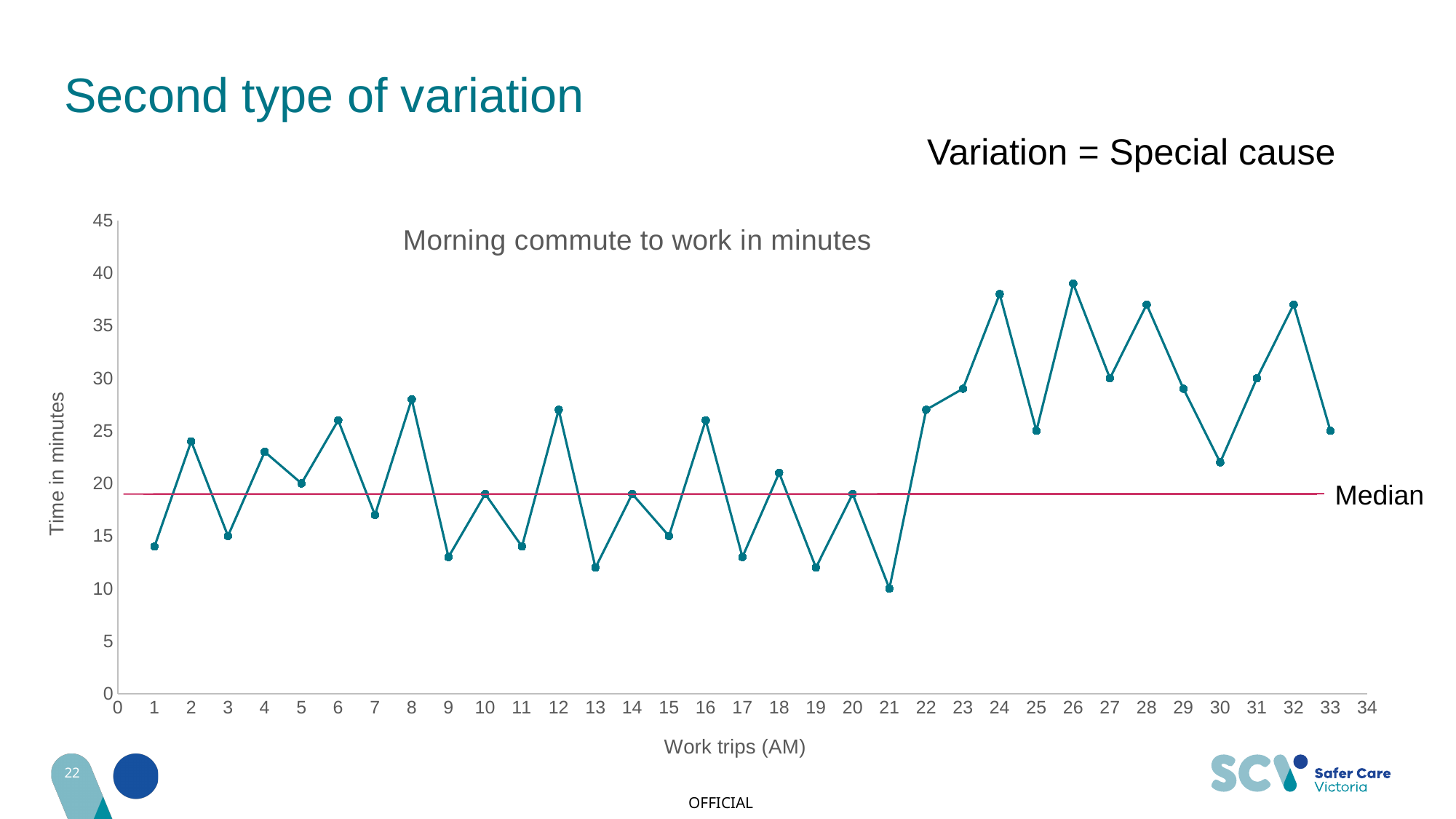
Is the value for work trip 13 greater or less than 15? less What is the time in minutes for work trip 5? 20 How many work trips are plotted on the chart? 33 What is the time in minutes for work trip 21? 10 Is the value for work trip 8 greater or less than 25? greater Do the commute times generally rise or fall from work trip 21 to work trip 26? Rise What does the horizontal red line across the chart represent? Median Which has a higher time in minutes, work trip 8 or work trip 9? Work trip 8 Which work trip has the lowest time in minutes? 21 Is the value for work trip 26 greater or less than 35? greater What is the title of the chart? Morning commute to work in minutes What kind of chart is shown on the slide? Line chart